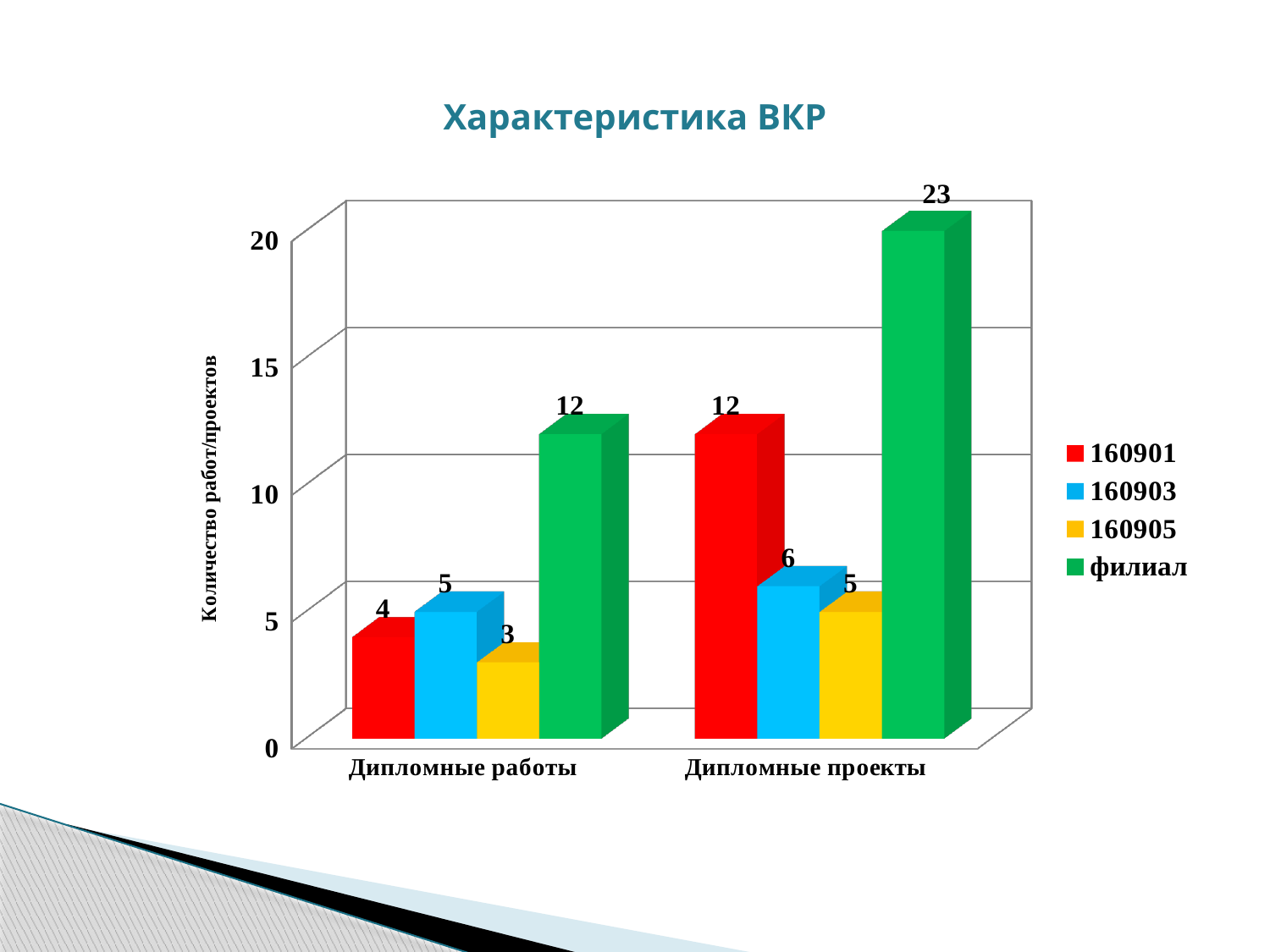
Which series has the lowest value in the Дипломные работы category? 160905 What is the difference between the филиал values for Дипломные проекты and Дипломные работы? 11 What is the value for филиал in the Дипломные проекты category? 23 Is the value for филиал in Дипломные проекты greater or less than 20? greater What is the title of the slide? Характеристика ВКР Which is larger: the 160901 value for Дипломные проекты or the 160903 value for Дипломные проекты? 160901 What kind of chart is shown on the slide? bar chart Which series has the highest value in the Дипломные работы category? филиал How many categories are shown on the x axis? 2 What is the value for 160901 in the Дипломные работы category? 4 How many series does the legend list? 4 What is the value for 160905 in the Дипломные проекты category? 5